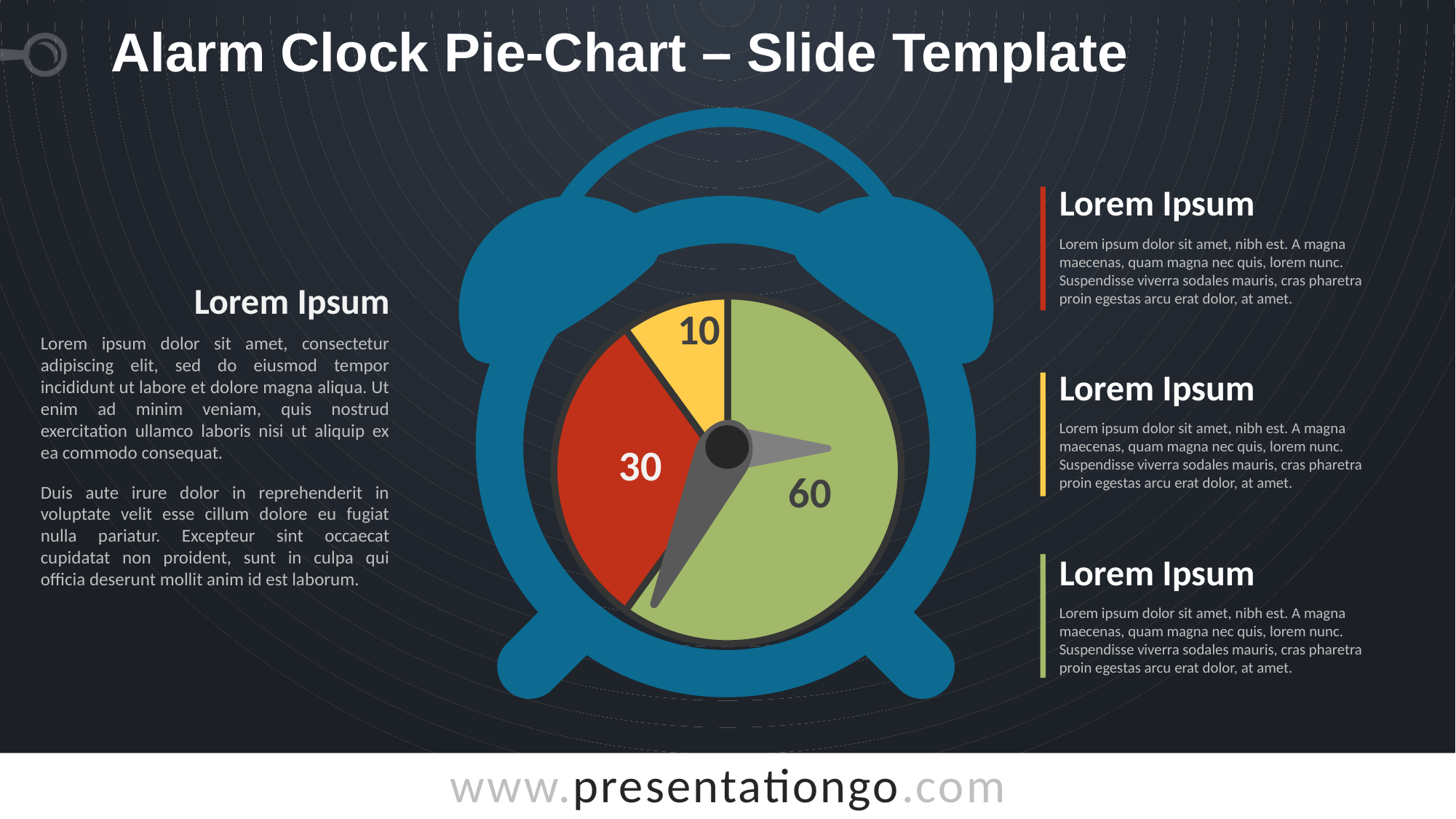
What is the difference between the green slice and the red slice values? 30 What kind of chart is shown inside the alarm clock? pie chart Which slice of the pie chart has the smallest value? the yellow slice (10) What value is printed on the red slice of the pie chart? 30 What value is printed on the green slice of the pie chart? 60 Which slice of the pie chart has the largest value? the green slice (60) Which is larger, the red slice or the yellow slice? the red slice How many slices does the pie chart have? 3 What is the total of all the slice values in the pie chart? 100 What share of the pie does the green slice represent? 60% What colour is the slice labelled 30? red What value is printed on the yellow slice of the pie chart? 10